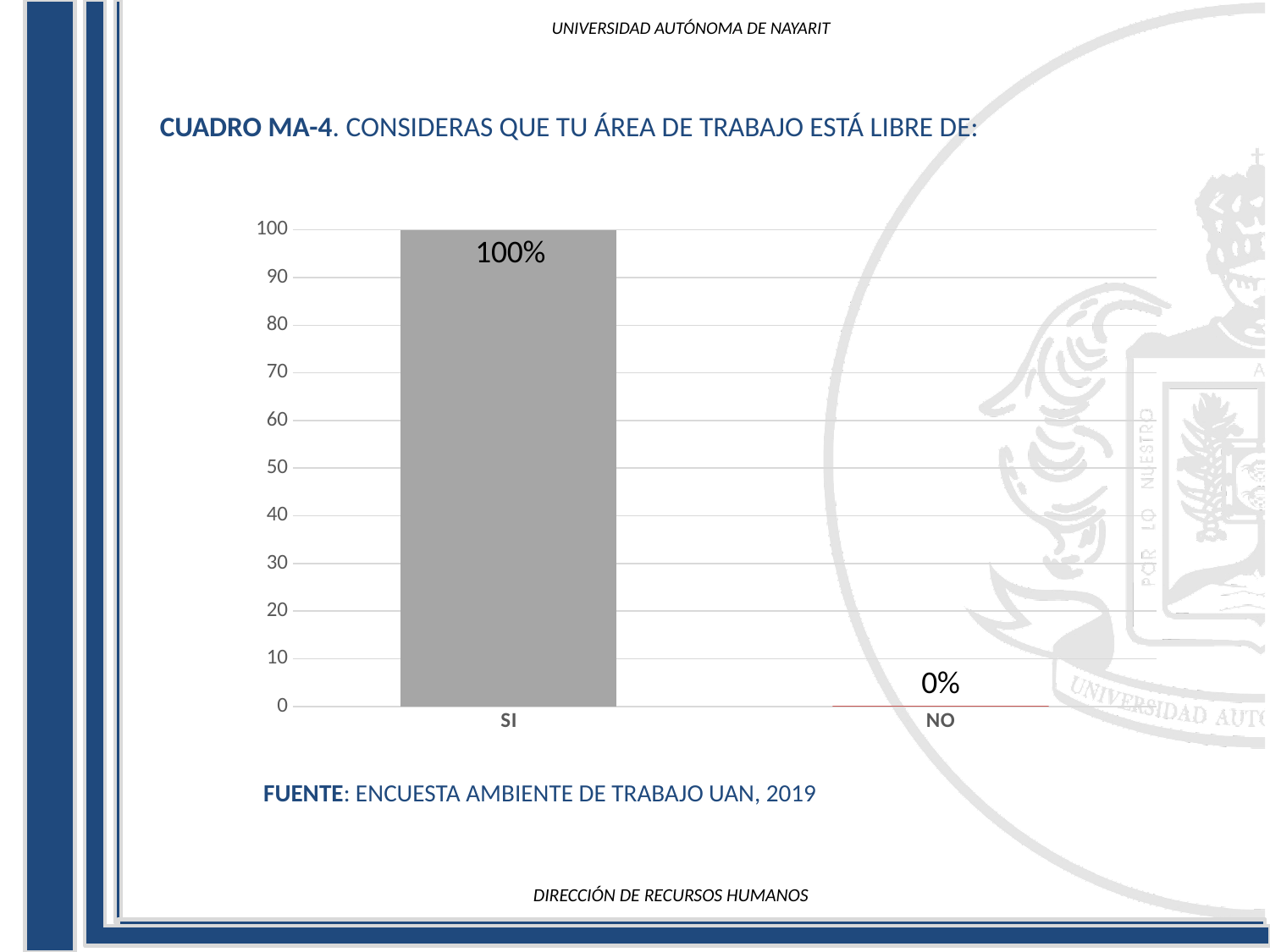
What kind of chart is shown on the slide? bar chart What is the value for SI? 100% Which category has the highest value? SI What is the value for NO? 0% Is the value for SI greater or less than 50? greater What is the difference between the values for SI and NO? 100% What is the source cited below the chart? ENCUESTA AMBIENTE DE TRABAJO UAN, 2019 Which category has the lowest value? NO How many categories are shown on the x axis? 2 What is the highest value shown on the y axis? 100 Do the values rise or fall from SI to NO? fall Which is larger, the value for SI or the value for NO? SI